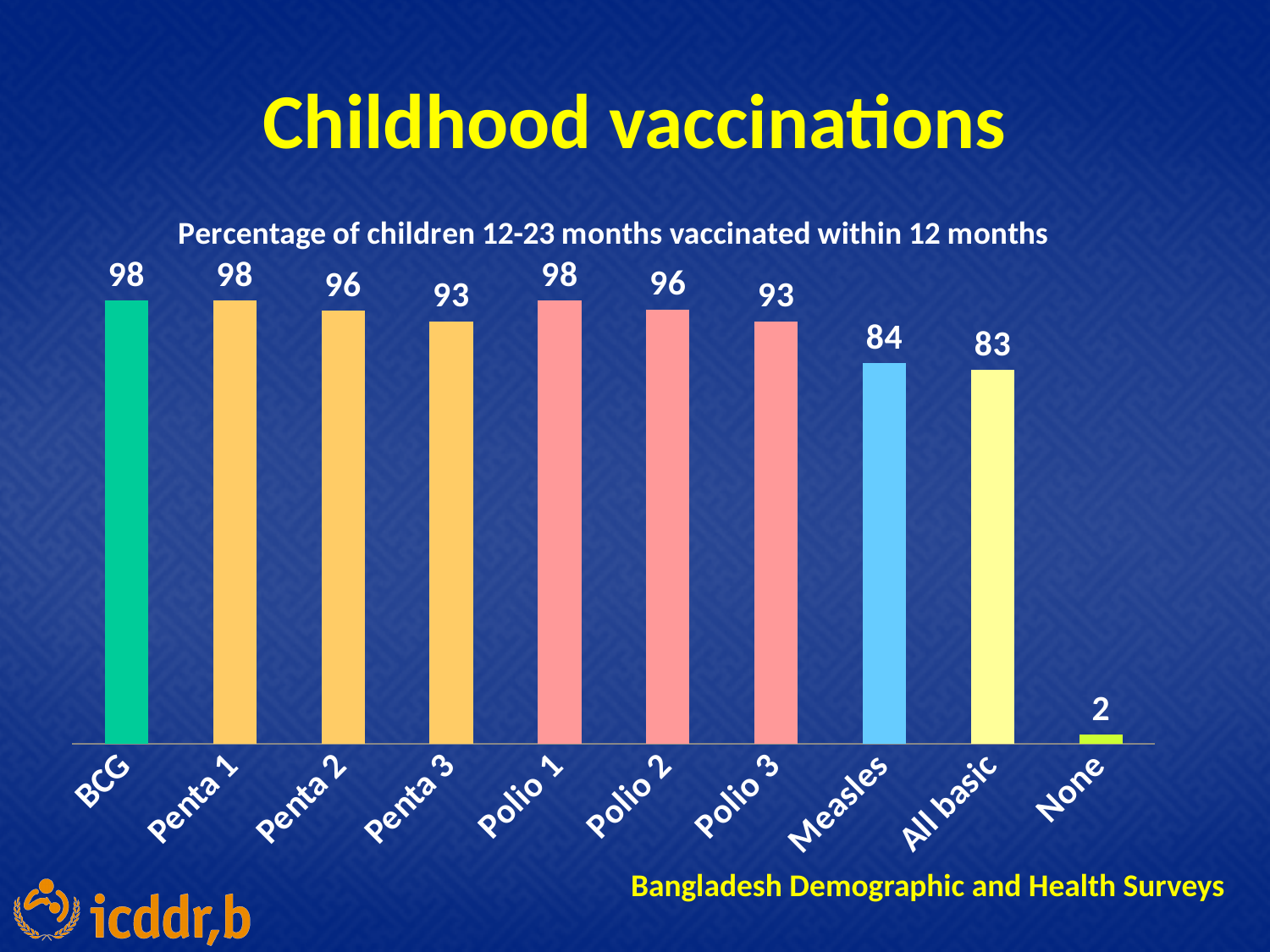
Which category has the lowest value? None How many categories are shown on the chart? 10 Which is larger, the value for Polio 3 or the value for All basic? Polio 3 What is the value for Penta 3? 93 What is the value for All basic? 83 What is the difference between the values for Penta 1 and Penta 3? 5 What kind of chart is shown on the slide? Bar chart What is the difference between the values for Measles and All basic? 1 What is the value for None? 2 What is the value for Measles? 84 Which is larger, the value for Polio 2 or the value for Measles? Polio 2 What is the subtitle printed above the chart? Percentage of children 12-23 months vaccinated within 12 months